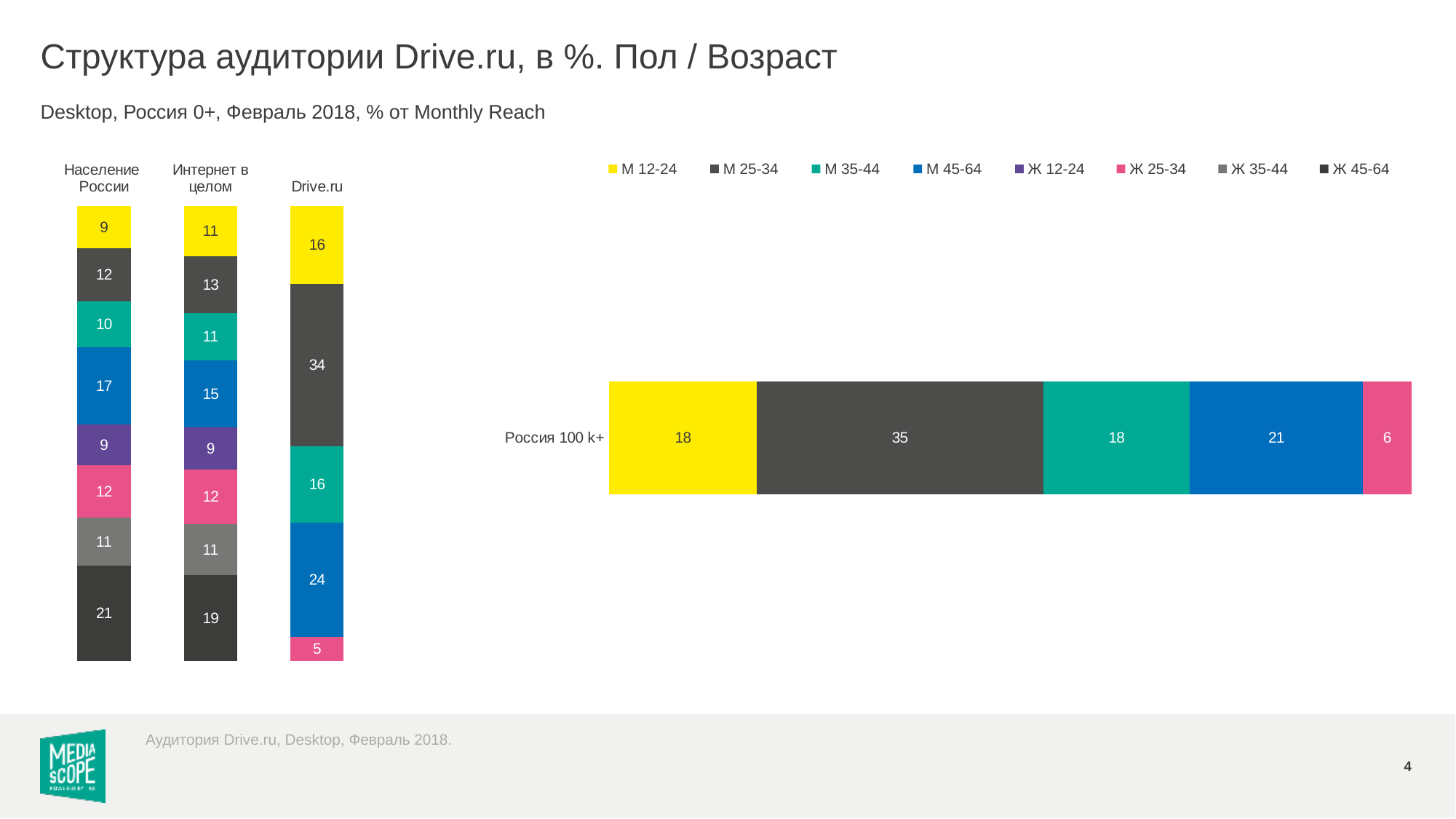
What kind of chart is the right chart (Россия 100 k+)? Stacked bar chart In the left chart, which bar has the larger Ж 45-64 value: Население России or Интернет в целом? Население России In the left chart, what is the difference between the М 45-64 value for Drive.ru and the М 45-64 value for Население России? 7 In the left chart, what is the value of the М 25-34 segment in the Drive.ru bar? 34 In the left chart, which segment of the Drive.ru bar has the smallest value? Ж 25-34 How many series does the legend on the slide list? 8 In the left chart, what is the value of the Ж 12-24 segment in the Население России bar? 9 In the right chart (Россия 100 k+), what is the value of the М 25-34 segment? 35 What is the title of the slide? Структура аудитории Drive.ru, в %. Пол / Возраст In the right chart, what is the total of the Россия 100 k+ bar? 98 In the left chart, which segment of the Drive.ru bar has the largest value? М 25-34 How many stacked bars are in the left chart? 3